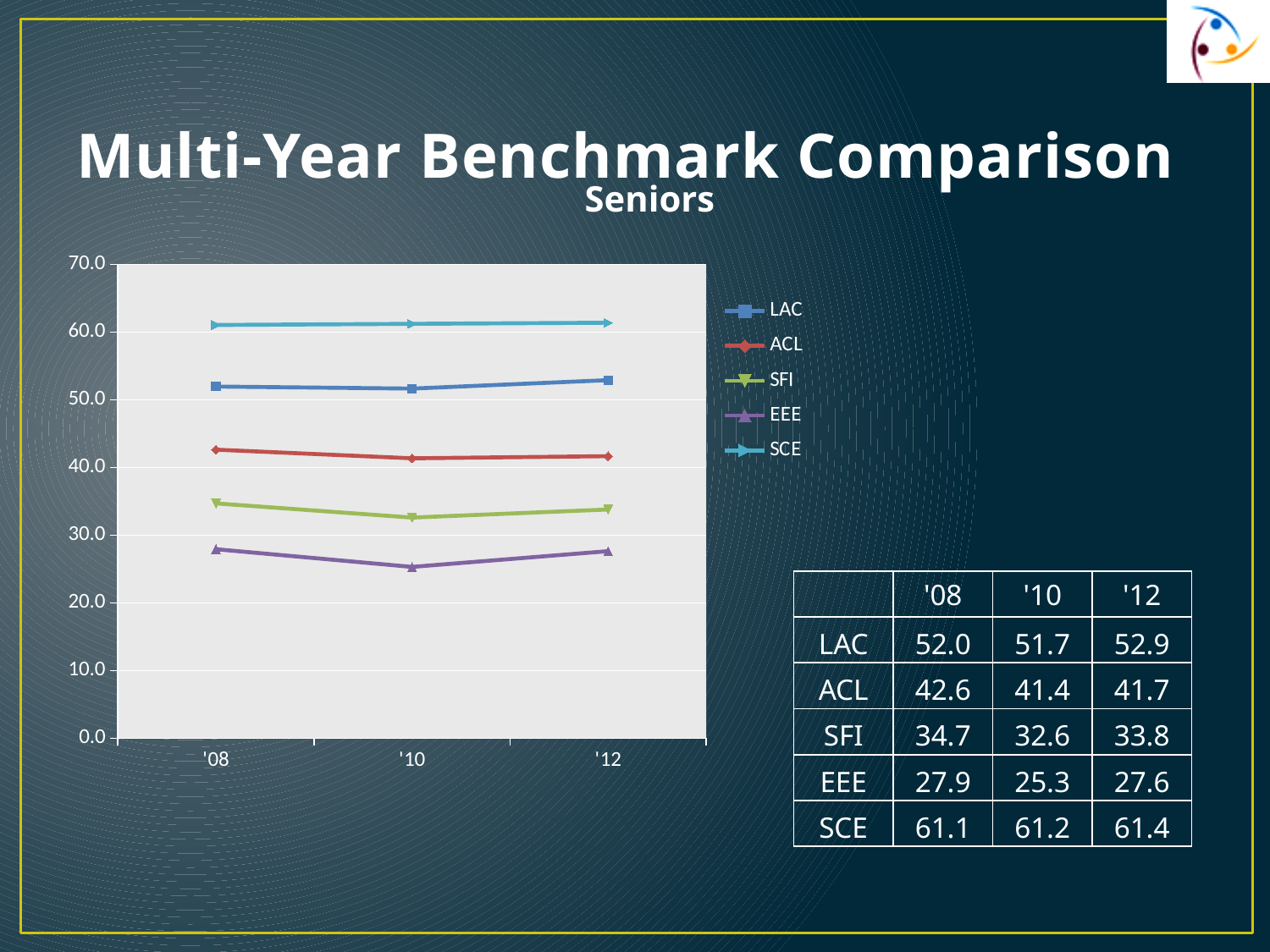
What is the difference between the SFI values in '08 and '10? 2.1 Which series has the highest values across all years? SCE Is the value for LAC in '10 greater or less than 50.0? greater Which is larger, the ACL value in '08 or the ACL value in '12? '08 How many series does the chart legend list? 5 Which series has the lowest values across all years? EEE What is the value for EEE in '10? 25.3 What is the value for SCE in '08? 61.1 How many years are plotted along the x axis? 3 What kind of chart is shown on the slide? line chart Does the EEE series rise or fall from '08 to '10? fall What is the value for LAC in '12? 52.9